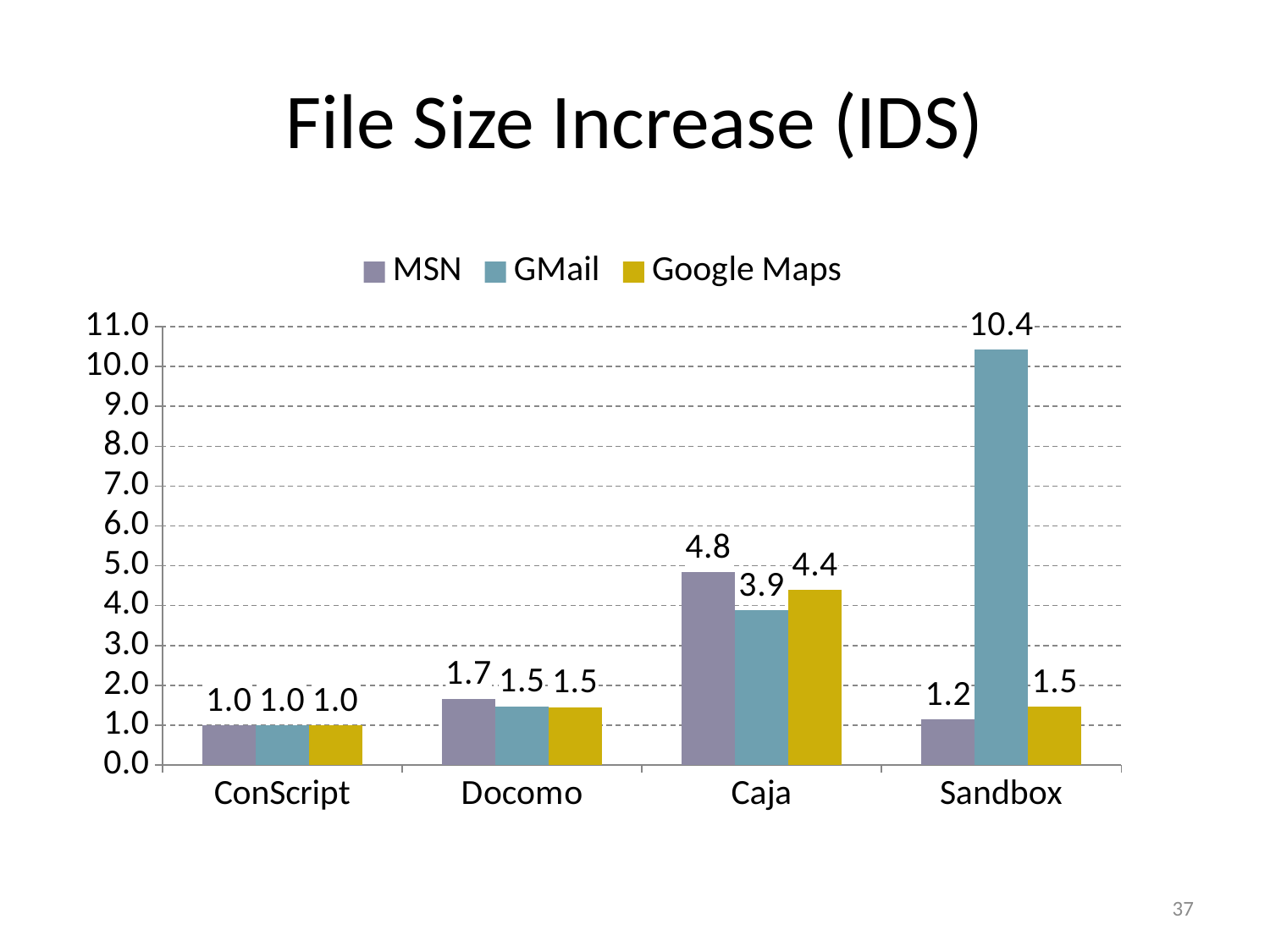
What is the MSN value for Caja? 4.8 Which category has the lowest MSN value? ConScript What is the Google Maps value for Docomo? 1.5 How many categories are shown on the x axis? 4 What kind of chart is shown on the slide? Bar chart Is the GMail value for Sandbox greater or less than 10.0? greater What is the MSN value for Sandbox? 1.2 What is the GMail value for Sandbox? 10.4 Which is larger for Caja: the MSN value or the Google Maps value? MSN What is the difference between the GMail value for Sandbox and the GMail value for Caja? 6.5 How many series does the legend list? 3 Which category has the highest GMail value? Sandbox